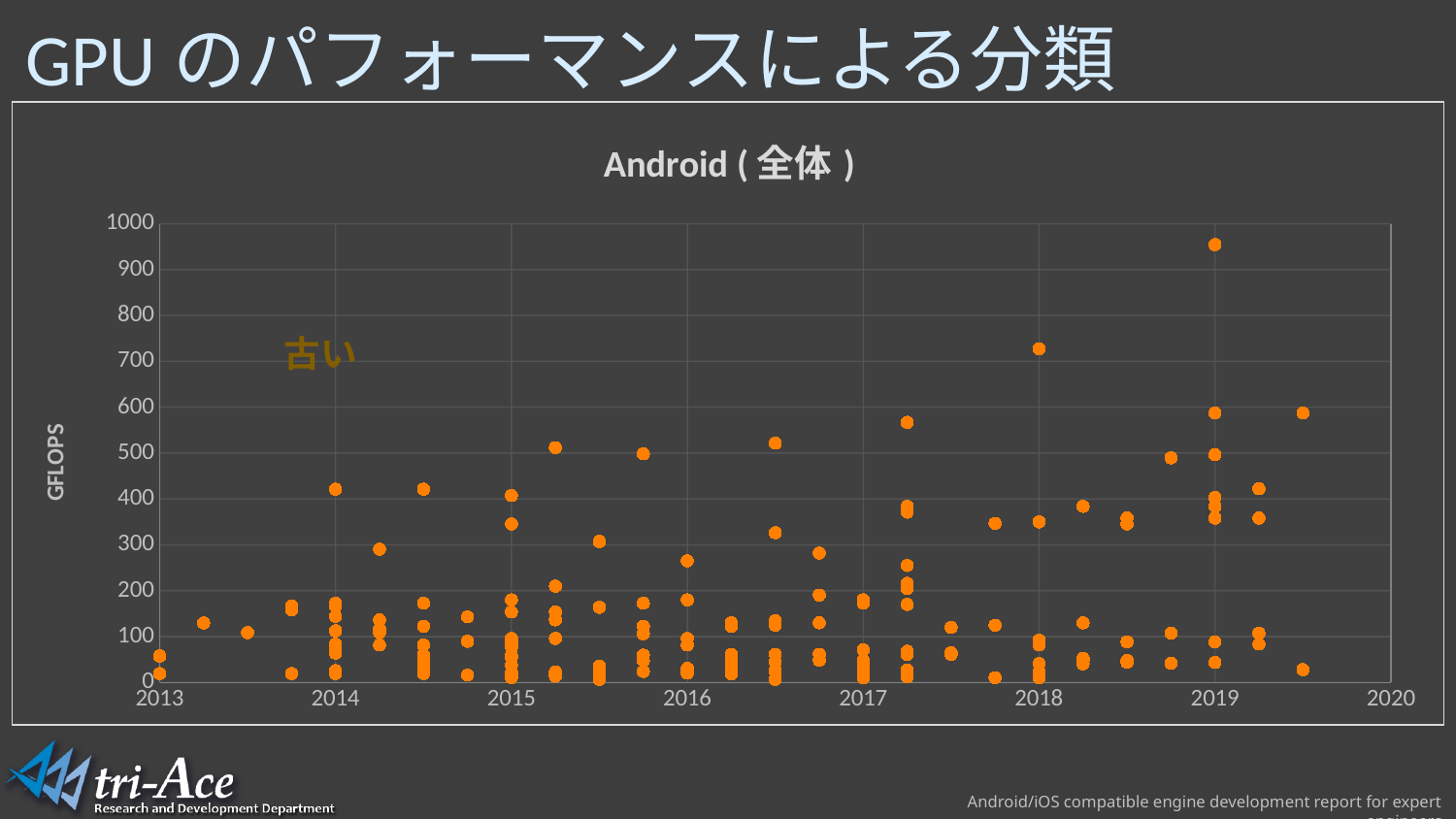
Do the maximum plotted GFLOPS values generally rise or fall from 2013 to 2019? rise Is the highest value plotted near 2013 greater or less than 100? less What is the maximum value shown on the vertical axis? 1000 What is the title of the chart? Android ( 全体 ) Is the highest value plotted near 2018 greater or less than 700? greater Around which year on the x axis does the highest plotted point appear? 2019 What is the label on the vertical axis of the chart? GFLOPS Is the highest plotted point near 2019 higher or lower than the highest plotted point near 2018? higher Is the highest value plotted near 2016 greater or less than 200? greater What kind of chart is shown on the slide? scatter chart